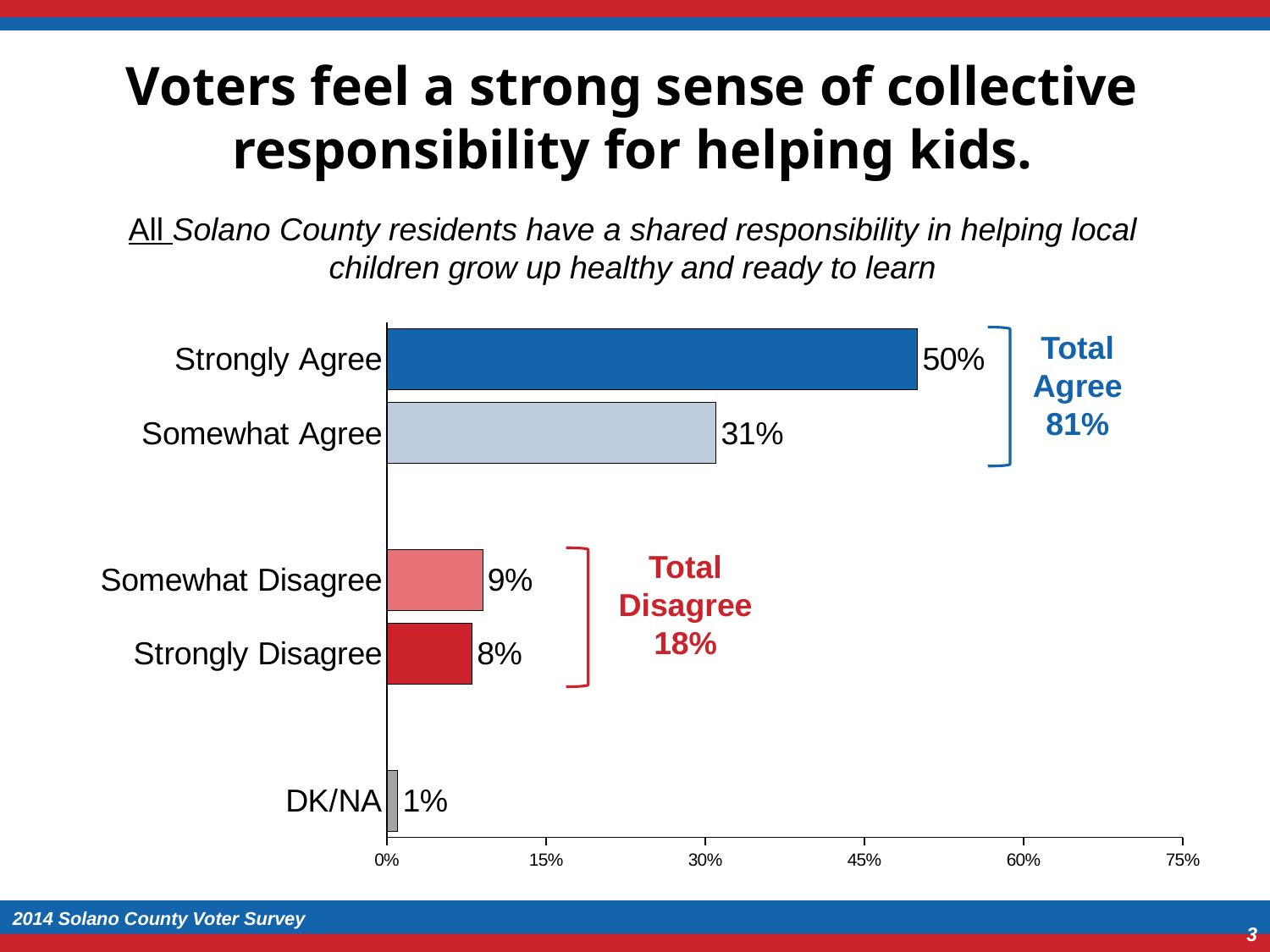
Which response category has the highest percentage? Strongly Agree What percentage of voters strongly agree that all Solano County residents have a shared responsibility in helping local children? 50% What percentage of voters somewhat disagree? 9% What is the Total Agree percentage shown on the chart? 81% What percentage of voters strongly disagree? 8% How many response categories are shown in the chart? 5 What type of chart is shown on the slide? Bar chart Which is larger, the percentage for Somewhat Agree or for Somewhat Disagree? Somewhat Agree What is the difference in percentage points between Strongly Agree and Somewhat Agree? 19 What percentage of voters answered DK/NA? 1% Which response category has the lowest percentage? DK/NA What percentage of voters somewhat agree? 31%